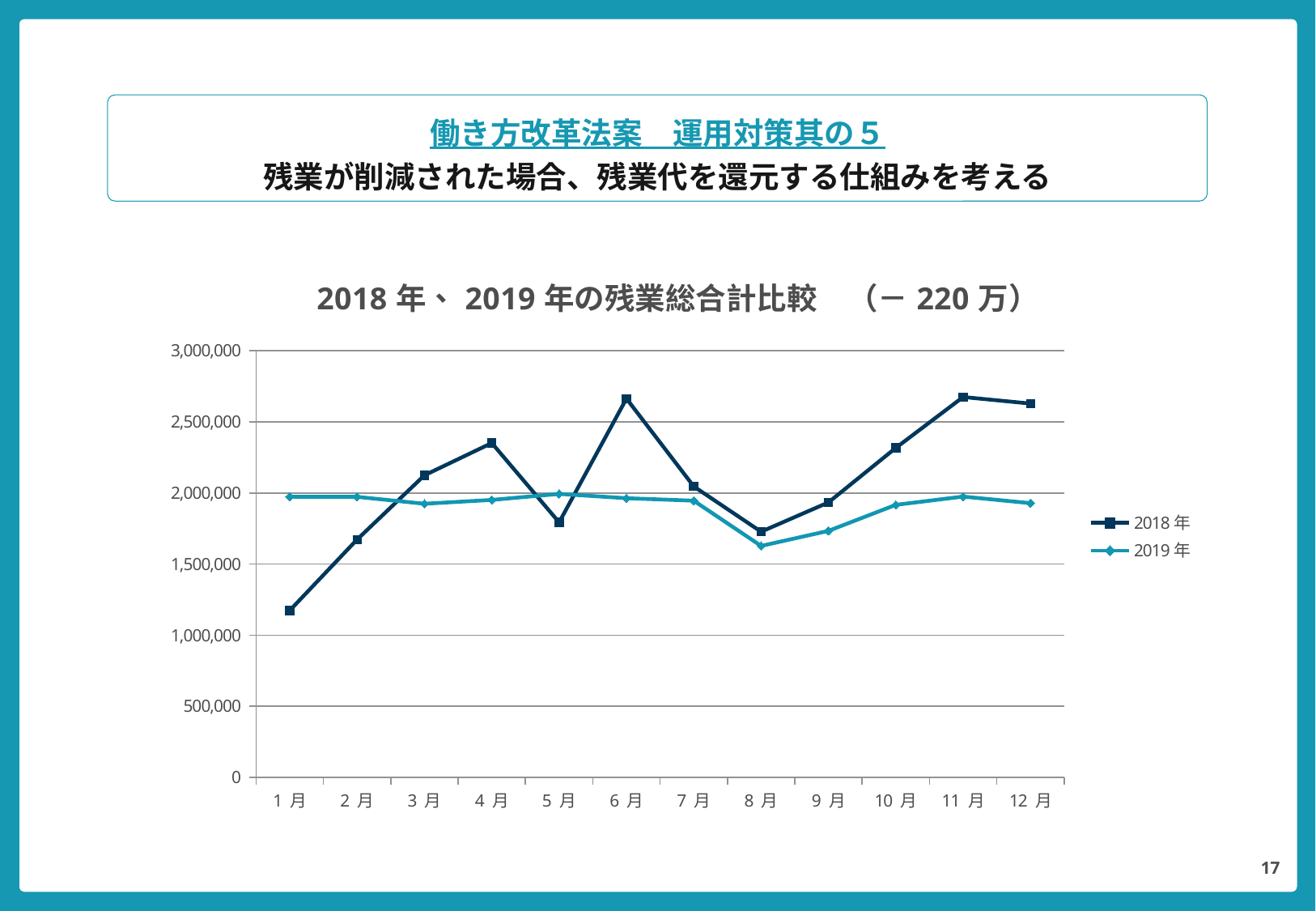
Is the value for 2018年 in 1月 greater or less than 1,500,000? less Does the 2018年 series rise or fall from 1月 to 4月? rise In 1月, which series has the larger value, 2018年 or 2019年? 2019年 Which month has the lowest value for the 2019年 series? 8月 How many months are plotted along the x axis? 12 Is the value for 2019年 in 8月 greater or less than 2,000,000? less How many series does the legend list? 2 Which month has the lowest value for the 2018年 series? 1月 What kind of chart is shown on the slide? line chart In 6月, which series has the larger value, 2018年 or 2019年? 2018年 What are the two entries listed in the legend? 2018年 and 2019年 Is the value for 2018年 in 6月 greater or less than 2,500,000? greater